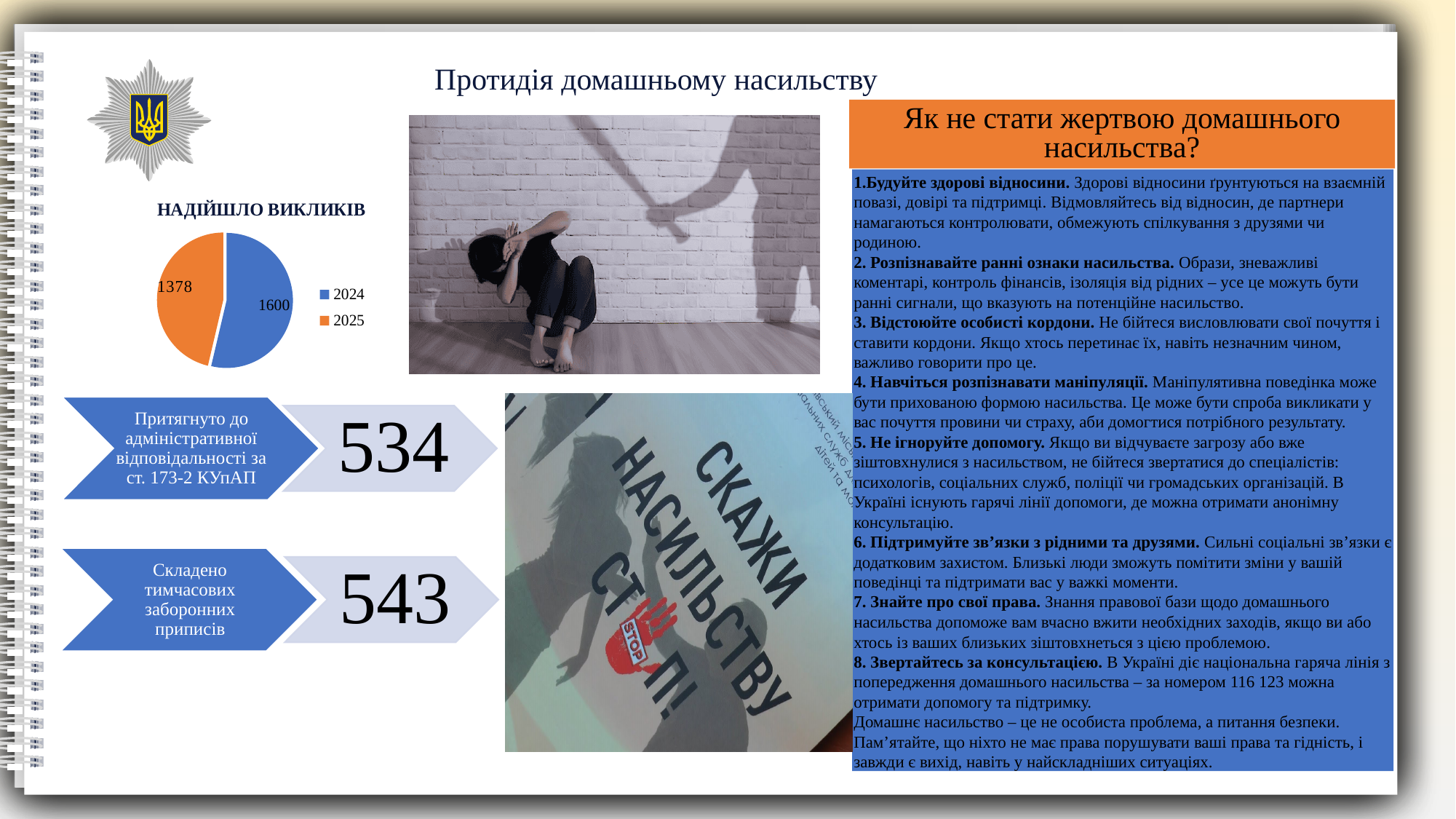
What is the difference between the 2024 and 2025 values in the pie chart? 222 Which colour represents 2025 in the pie chart? orange What type of chart is shown under the title "НАДІЙШЛО ВИКЛИКІВ"? pie chart How many slices does the pie chart have? 2 What is the total of the two values shown in the pie chart? 2978 How many entries does the legend of the pie chart list? 2 What is the value for 2025 in the pie chart? 1378 What is the title of the pie chart? НАДІЙШЛО ВИКЛИКІВ What is the value for 2024 in the pie chart? 1600 Which year has the smaller slice in the pie chart? 2025 Is the value for 2024 larger or smaller than the value for 2025 in the pie chart? larger Which year has the larger slice in the pie chart? 2024